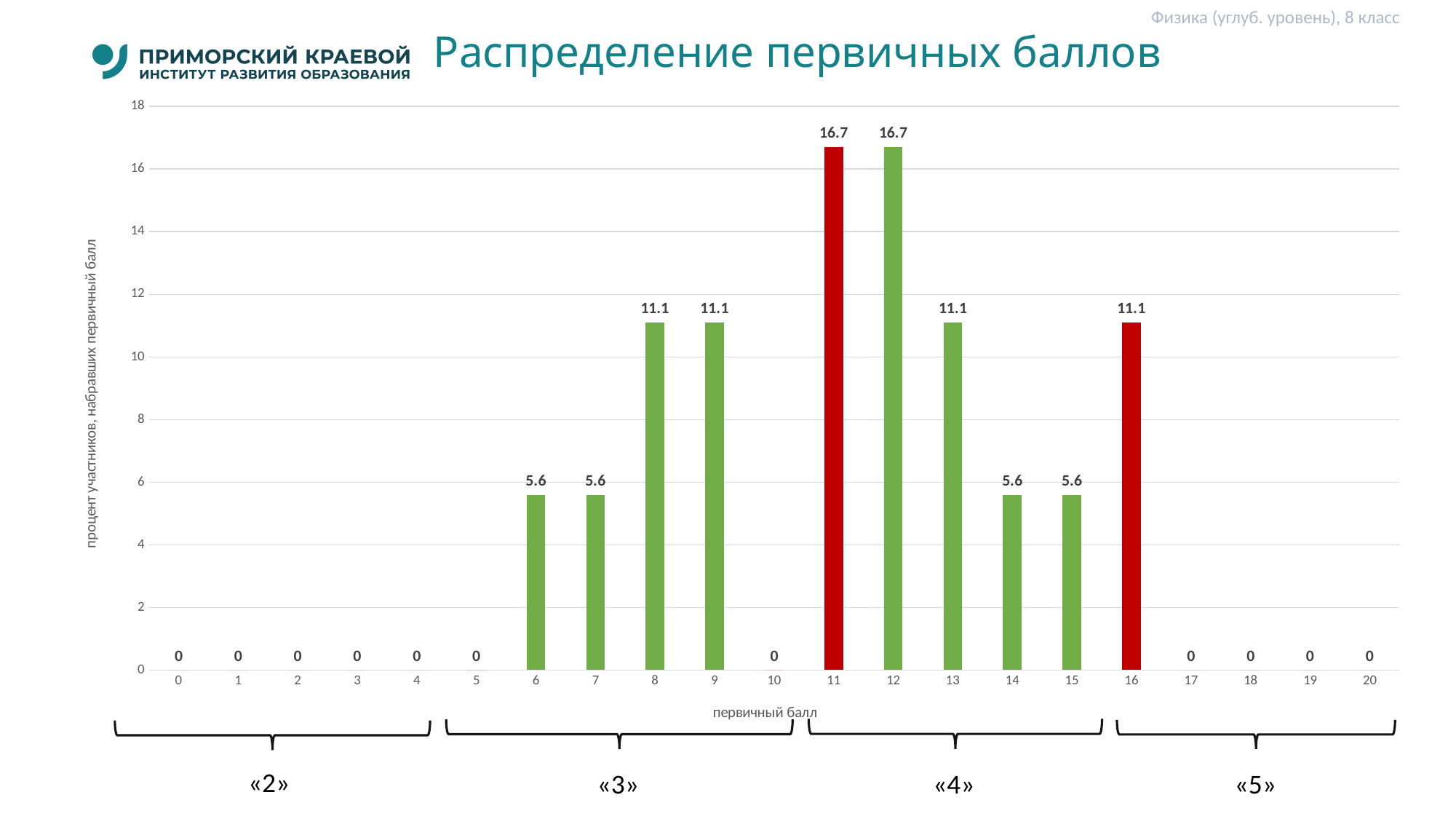
What is the value for primary score 16? 11.1 What is the highest value shown on the chart? 16.7 Is the value for primary score 13 greater or less than 10? greater What is the value for primary score 10? 0 What kind of chart is shown on the slide? bar chart What is the difference between the values for primary scores 12 and 14? 11.1 What is the value for primary score 11? 16.7 Which has a larger value, primary score 8 or primary score 15? 8 Which primary scores have red bars? 11 and 16 How many primary score categories are shown on the x axis? 21 What is the value for primary score 6? 5.6 What is the title of the chart? Распределение первичных баллов